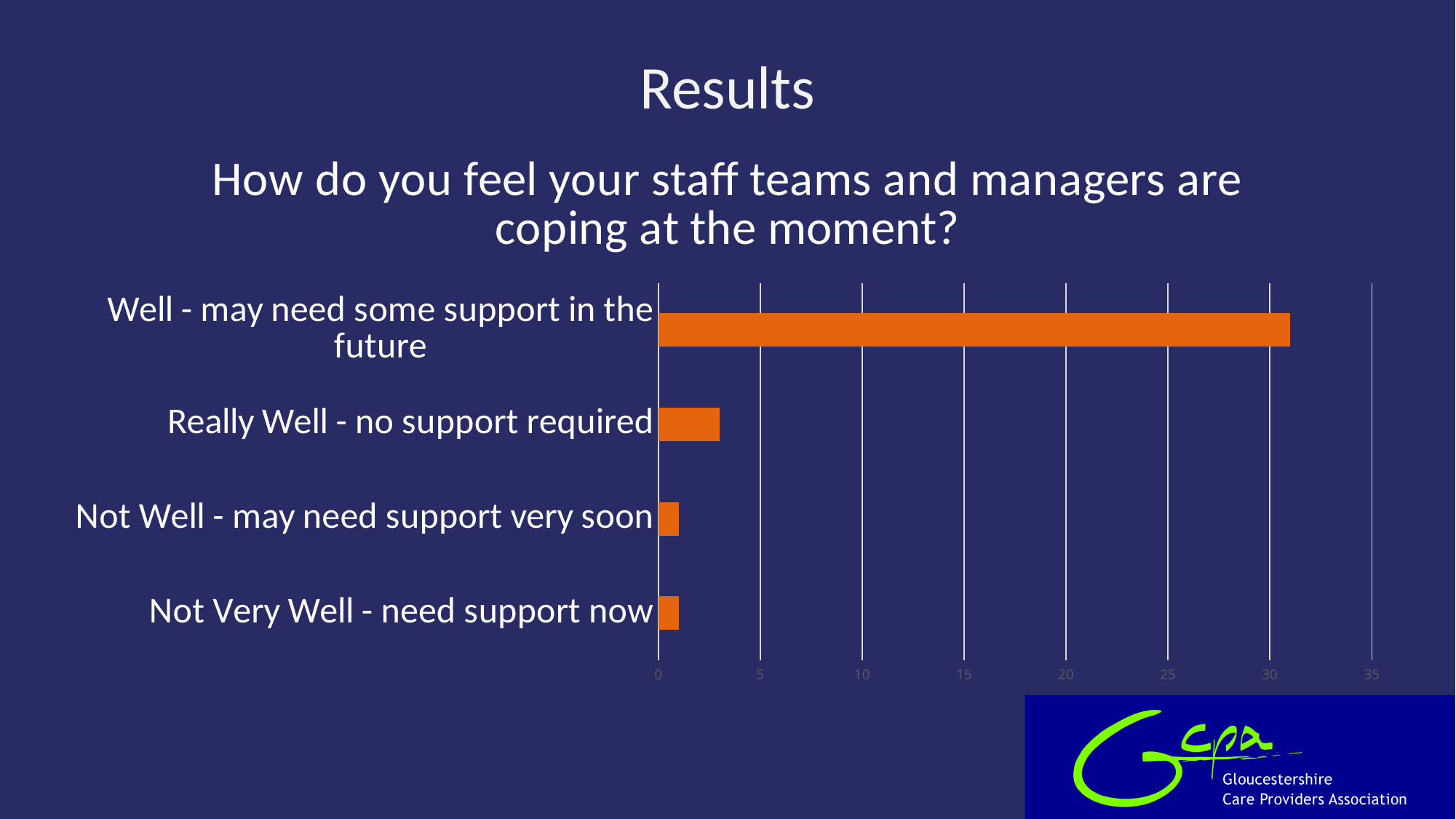
Is the value for "Well - may need some support in the future" greater or less than 25? greater How many categories does the chart show? 4 Is the value for "Not Very Well - need support now" greater or less than 5? less What question does the chart present results for? How do you feel your staff teams and managers are coping at the moment? Which is larger: the value for "Really Well - no support required" or "Not Well - may need support very soon"? Really Well - no support required Is the value for "Not Well - may need support very soon" greater or less than 5? less What kind of chart is shown on the slide? bar chart What is the highest value shown on the x axis? 35 Which category has the highest value? Well - may need some support in the future Which is larger: the value for "Well - may need some support in the future" or "Really Well - no support required"? Well - may need some support in the future